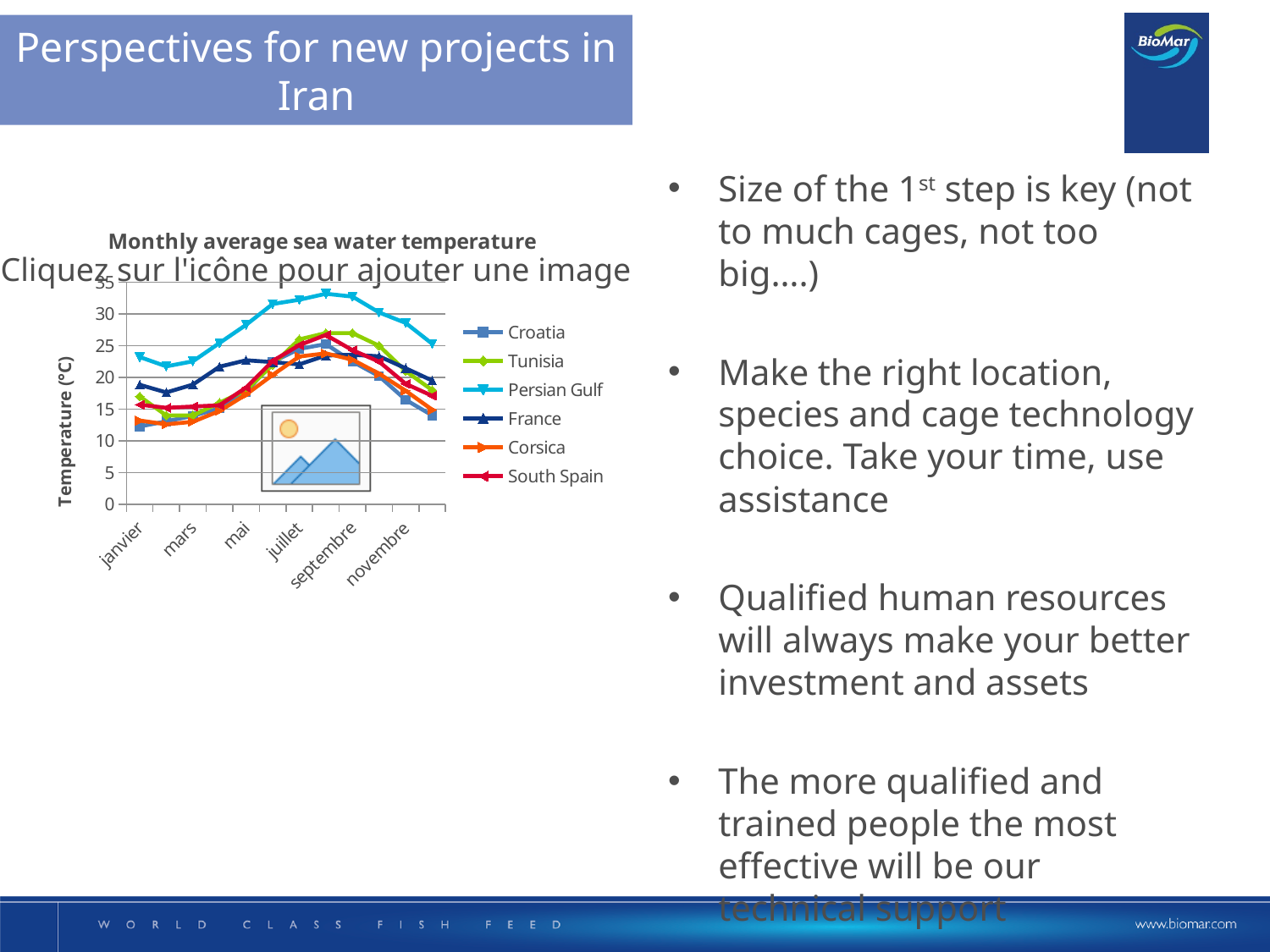
How many series does the legend of the sea water temperature chart list? 6 What is the label of the vertical axis? Temperature (°C) Is the value for Croatia in janvier greater or less than 15? less Which series reaches the highest temperature in the chart? Persian Gulf Is the value for Persian Gulf in janvier greater or less than 20? greater Does the Persian Gulf series rise or fall from janvier to juillet? rise Is the value for France in janvier greater or less than 15? greater In janvier, which is larger: the value for Tunisia or the value for Croatia? Tunisia Which series has the lowest temperature in janvier? Croatia What is the title of the chart? Monthly average sea water temperature What kind of chart is shown on the slide? line chart